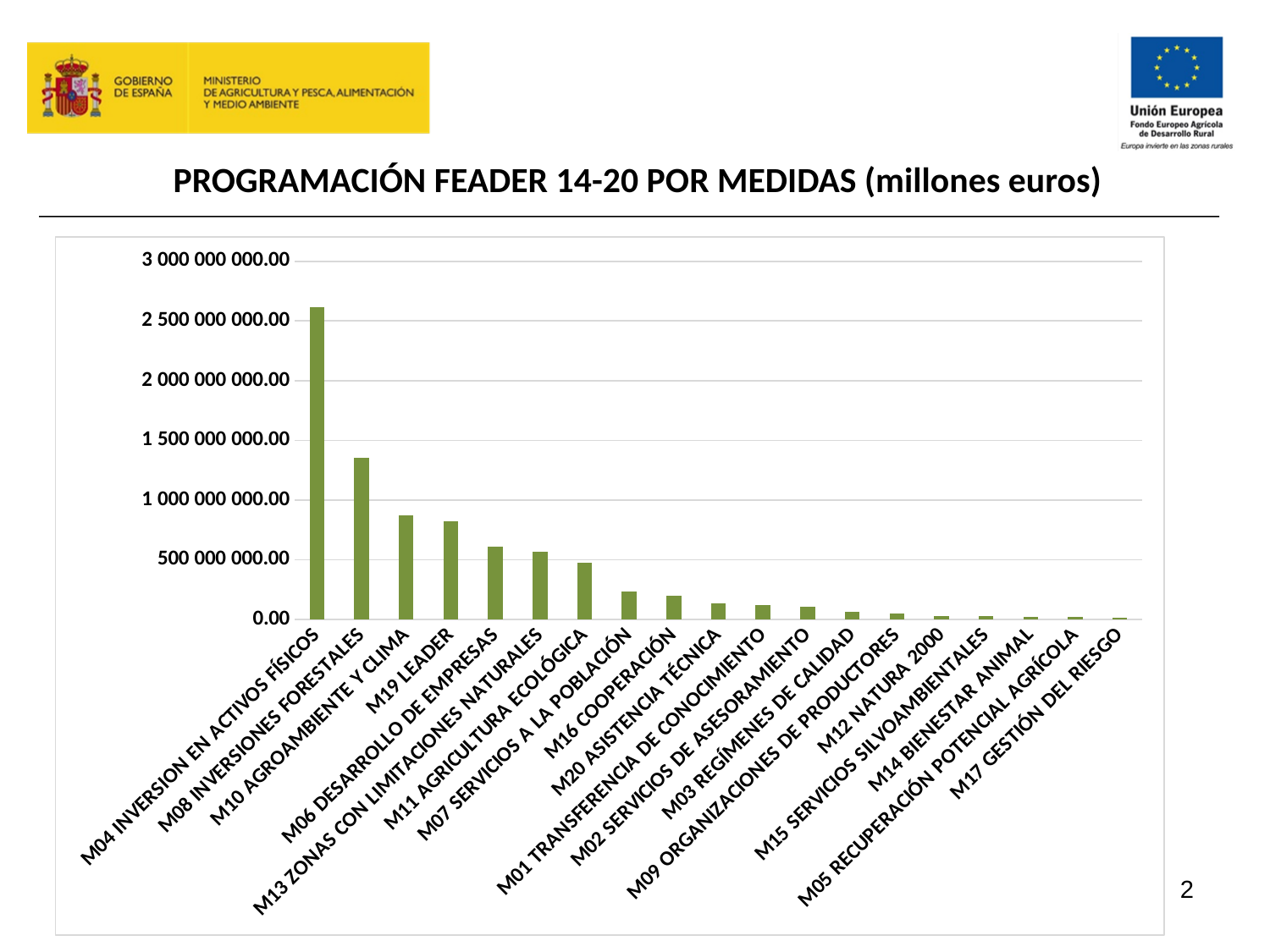
Is the value for M19 LEADER greater or less than 500 000 000.00? greater Do the values rise or fall moving from left to right along the x axis? fall Is the value for M07 SERVICIOS A LA POBLACIÓN greater or less than 500 000 000.00? less What is the title of the chart? PROGRAMACIÓN FEADER 14-20 POR MEDIDAS (millones euros) Is the value for M04 INVERSIÓN EN ACTIVOS FÍSICOS greater or less than 2 500 000 000.00? greater How many measures (categories) are plotted in the chart? 19 Which has the larger value, M04 INVERSIÓN EN ACTIVOS FÍSICOS or M08 INVERSIONES FORESTALES? M04 INVERSIÓN EN ACTIVOS FÍSICOS Which measure has the highest value in the chart? M04 INVERSIÓN EN ACTIVOS FÍSICOS Which has the larger value, M07 SERVICIOS A LA POBLACIÓN or M20 ASISTENCIA TÉCNICA? M07 SERVICIOS A LA POBLACIÓN What kind of chart is shown on the slide? bar chart